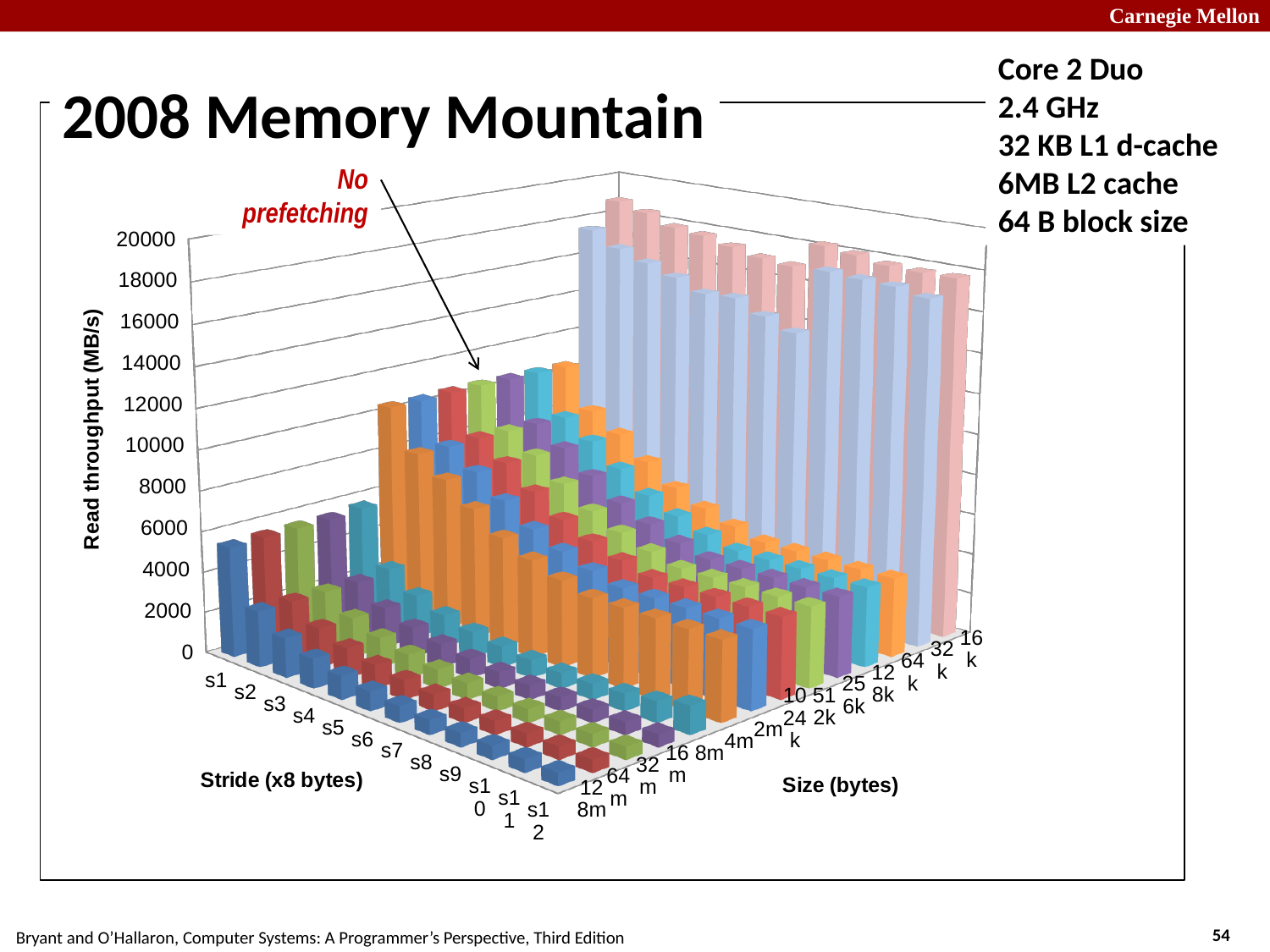
Is the read throughput for stride s1 at the front-left size (8m) greater or less than 10000? less At stride s1, which has the larger read throughput: size 16k or size 8m? 16k Is the read throughput for stride s12 at size 16k greater or less than 12000? greater What kind of chart is shown on the slide? bar chart Is the read throughput for stride s1 at size 16k greater or less than 14000? greater What is the label of the vertical axis? Read throughput (MB/s) What is the title of the chart? 2008 Memory Mountain What annotation with an arrow is written on the chart? No prefetching What is the highest tick value on the Read throughput (MB/s) axis? 20000 How many stride categories are shown on the stride axis? 12